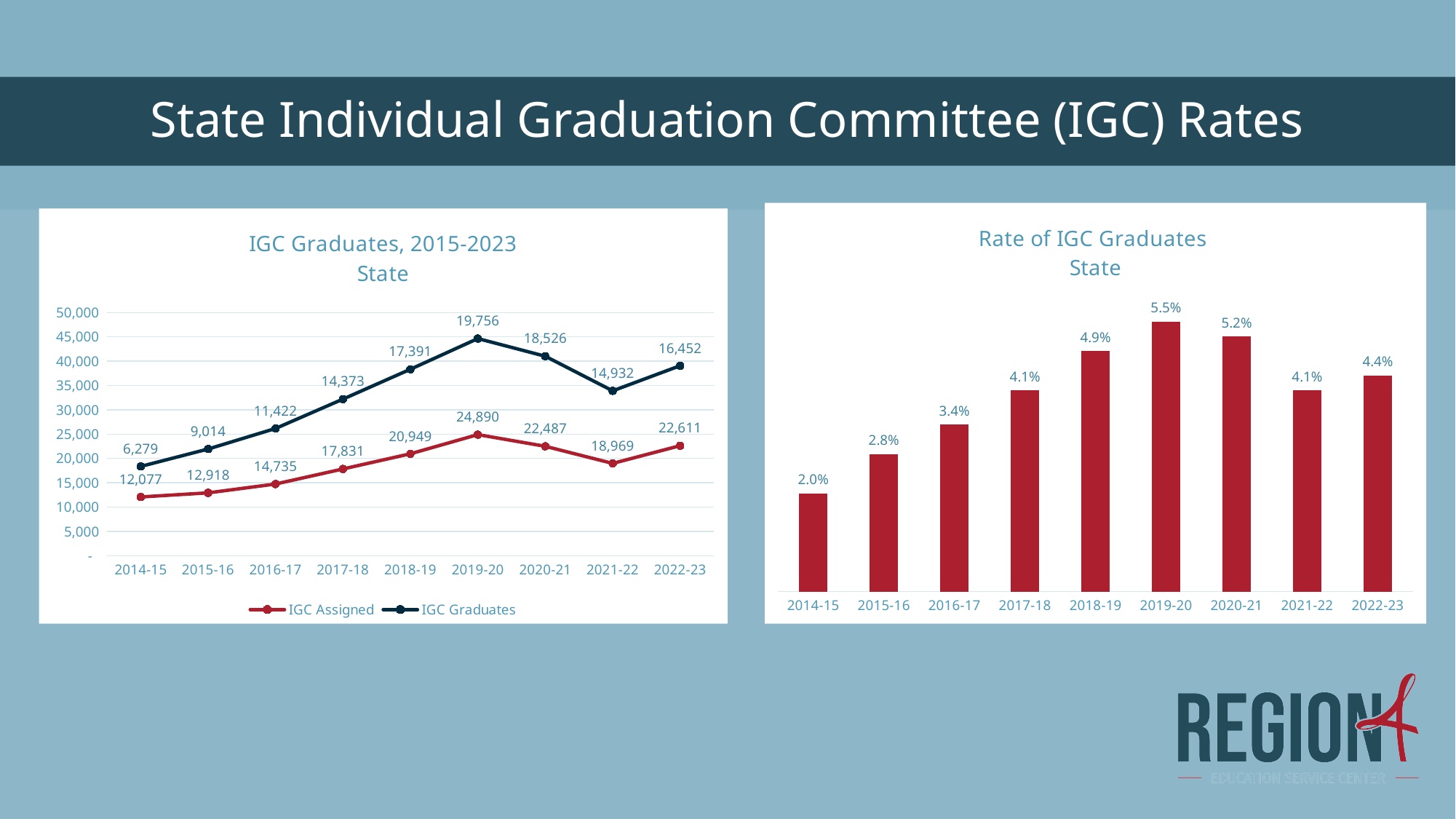
In the 'Rate of IGC Graduates' chart, what is the rate for 2019-20? 5.5% How many series does the legend of the 'IGC Graduates, 2015-2023' chart list? 2 How many years are shown in the 'Rate of IGC Graduates' chart? 9 In the 'Rate of IGC Graduates' chart, which year has the lowest rate? 2014-15 In the 'IGC Graduates, 2015-2023' chart, what is the IGC Assigned value for 2019-20? 24,890 In the 'Rate of IGC Graduates' chart, which year has the highest rate? 2019-20 In the 'IGC Graduates, 2015-2023' chart, which year has the higher IGC Assigned value, 2018-19 or 2020-21? 2020-21 In the 'IGC Graduates, 2015-2023' chart, what is the difference between the IGC Assigned values for 2022-23 and 2021-22? 3,642 What kind of chart is the 'Rate of IGC Graduates' chart? Bar chart In the 'Rate of IGC Graduates' chart, how much higher is the 2019-20 rate than the 2014-15 rate? 3.5% In the 'IGC Graduates, 2015-2023' chart, what is the IGC Graduates value for 2022-23? 16,452 What kind of chart is the 'IGC Graduates, 2015-2023' chart? Line chart